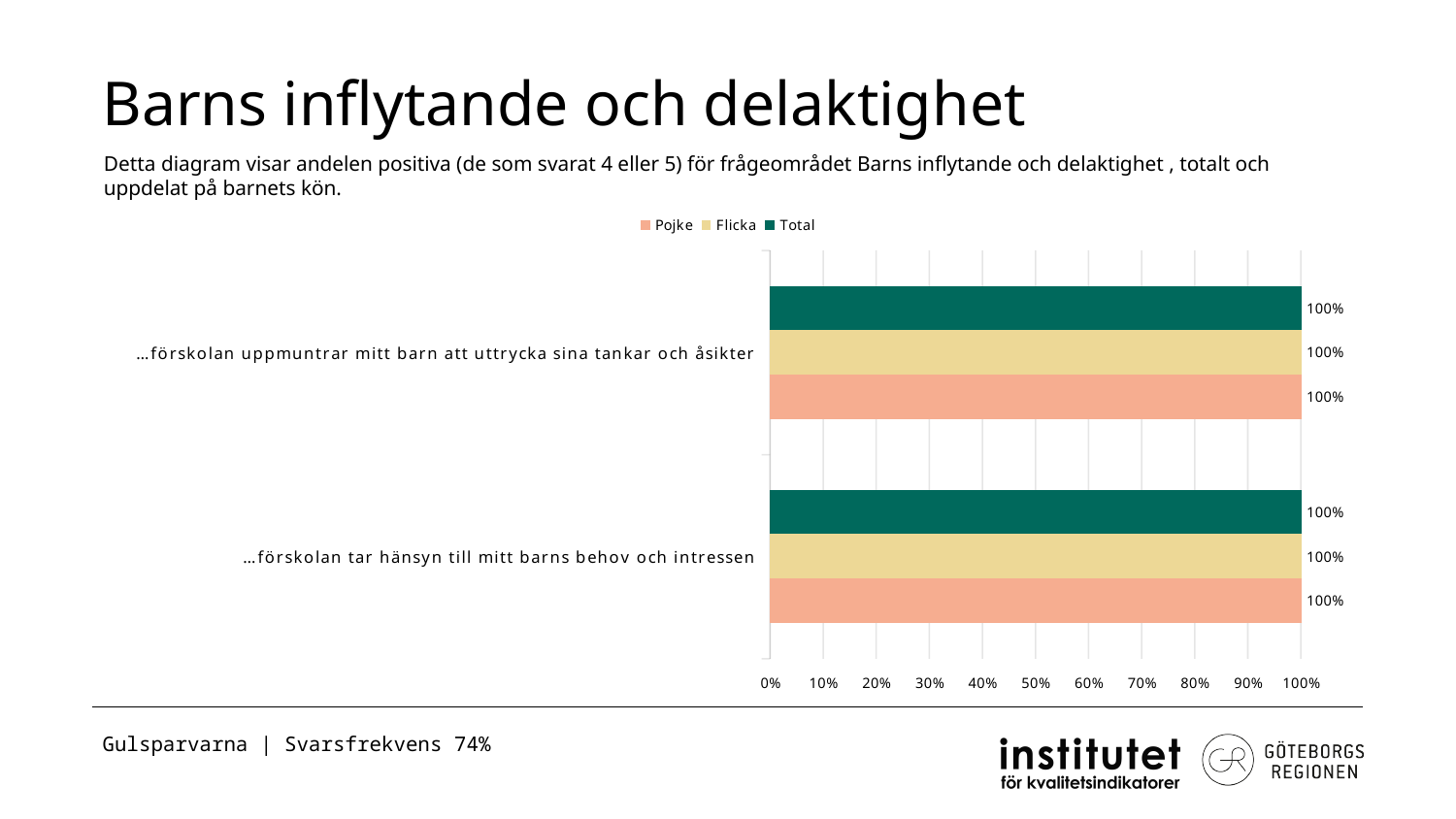
What is the difference between the Pojke and Flicka values for '…förskolan tar hänsyn till mitt barns behov och intressen'? 0% What is the value for Total for '…förskolan uppmuntrar mitt barn att uttrycka sina tankar och åsikter'? 100% How many series does the legend list? 3 How many categories are plotted on the chart? 2 What is the value for Flicka for '…förskolan tar hänsyn till mitt barns behov och intressen'? 100% What kind of chart is shown on the slide? bar chart What is the highest value shown on the x axis? 100% What is the value for Pojke for '…förskolan uppmuntrar mitt barn att uttrycka sina tankar och åsikter'? 100% What is the value for Pojke for '…förskolan tar hänsyn till mitt barns behov och intressen'? 100% What is the value for Flicka for '…förskolan uppmuntrar mitt barn att uttrycka sina tankar och åsikter'? 100% Which series is shown in dark green in the legend? Total What is the value for Total for '…förskolan tar hänsyn till mitt barns behov och intressen'? 100%